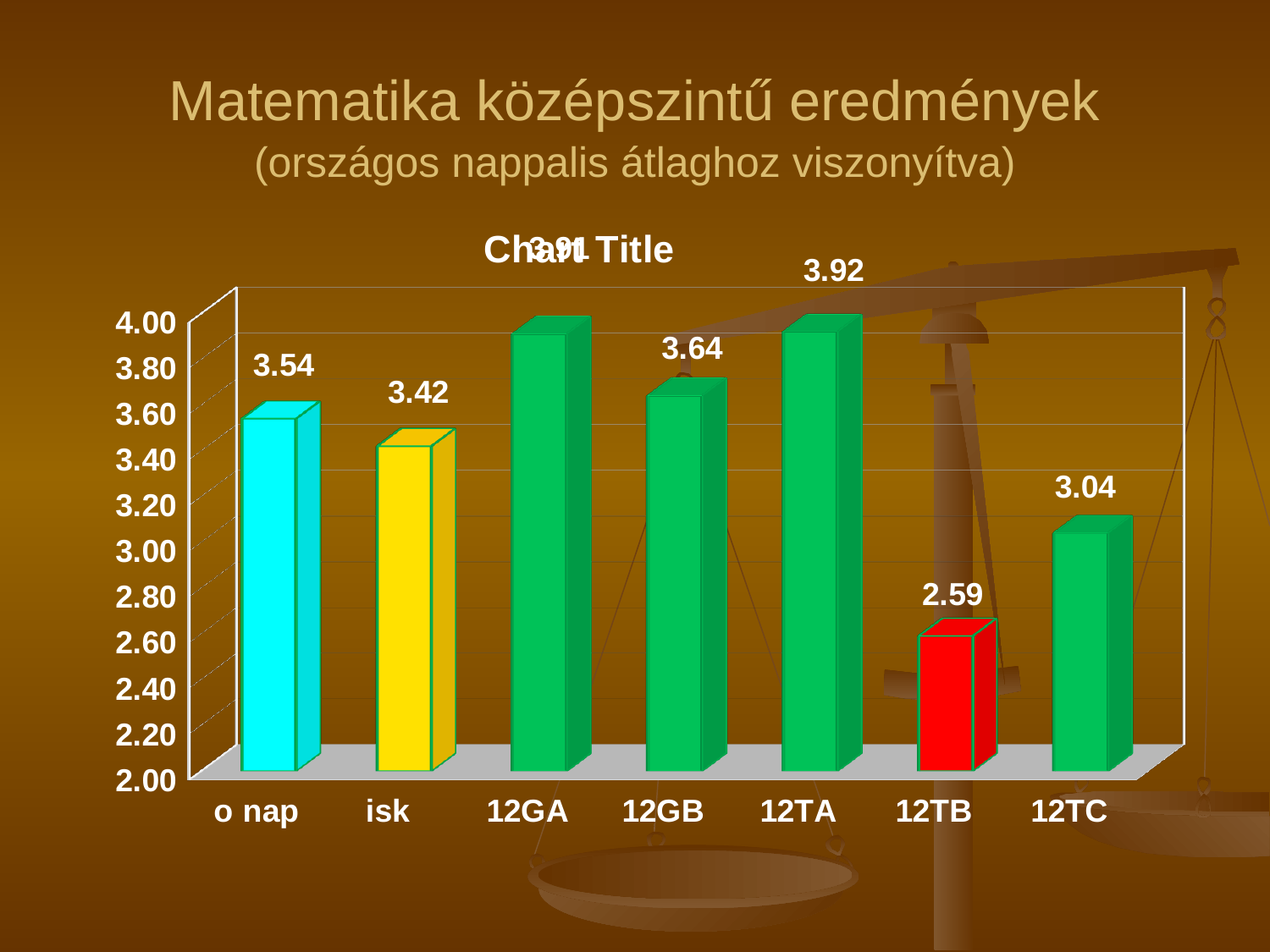
What is the difference between the values for o nap and isk? 0.12 What is the value for 12GB? 3.64 What is the value for 12TC? 3.04 What is the value for 12TA? 3.92 Which category has the lowest value? 12TB How many categories are shown on the x axis? 7 Which is larger, the value for 12GB or the value for 12TC? 12GB What is the difference between the values for 12TA and 12TB? 1.33 What kind of chart is shown on the slide? bar chart What is the value for o nap? 3.54 What is the value for isk? 3.42 What is the value for 12TB? 2.59